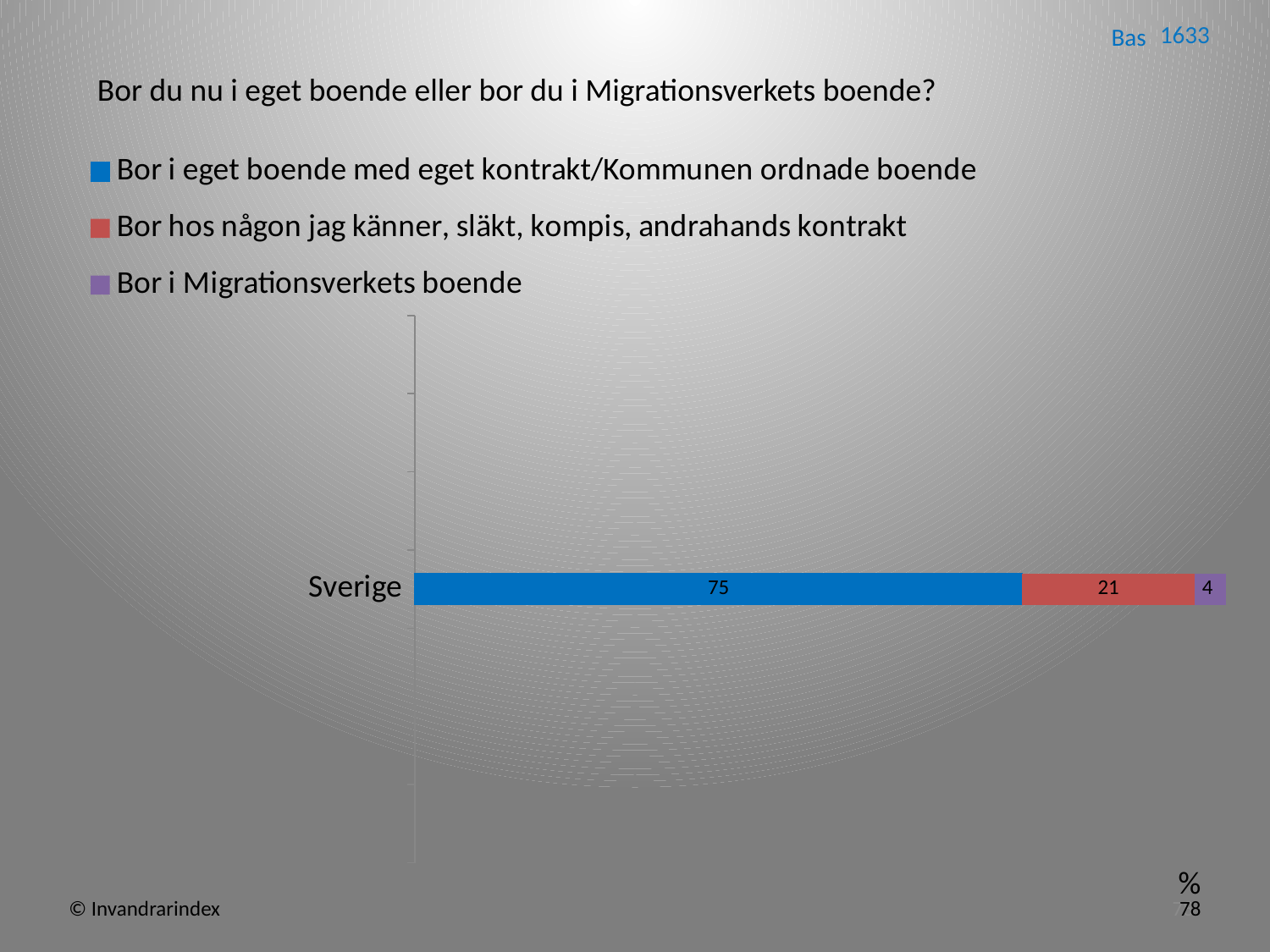
Which series has the lowest value for Sverige? Bor i Migrationsverkets boende What kind of chart is shown on the slide? Stacked bar chart How many categories are shown on the chart? 1 Which is larger: the value for "Bor hos någon jag känner, släkt, kompis, andrahands kontrakt" or for "Bor i Migrationsverkets boende"? Bor hos någon jag känner, släkt, kompis, andrahands kontrakt What is the total of the stacked bar for Sverige? 100 What is the value for "Bor i Migrationsverkets boende" for Sverige? 4 What is the value for "Bor i eget boende med eget kontrakt/Kommunen ordnade boende" for Sverige? 75 How many series does the legend list? 3 What is the difference between the values for "Bor i eget boende med eget kontrakt/Kommunen ordnade boende" and "Bor hos någon jag känner, släkt, kompis, andrahands kontrakt"? 54 What is the value for "Bor hos någon jag känner, släkt, kompis, andrahands kontrakt" for Sverige? 21 What colour represents "Bor i Migrationsverkets boende" in the chart? Purple Which series has the highest value for Sverige? Bor i eget boende med eget kontrakt/Kommunen ordnade boende